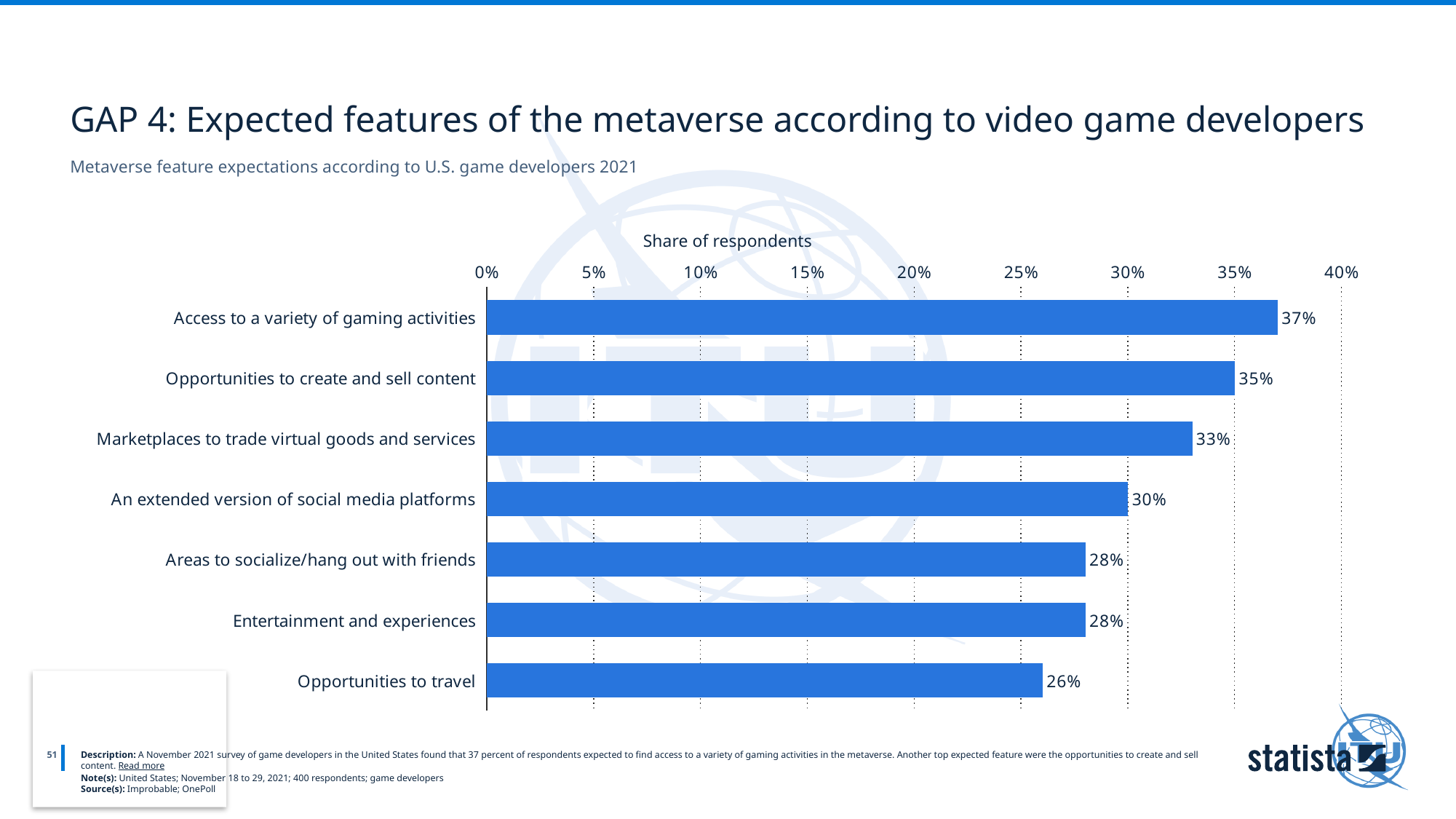
What is the difference between 'An extended version of social media platforms' and 'Areas to socialize/hang out with friends'? 2 percentage points What is the value for 'Marketplaces to trade virtual goods and services'? 33% What kind of chart is shown on the slide? Bar chart Which feature has the highest share of respondents? Access to a variety of gaming activities What is the label of the value axis of the chart? Share of respondents How many features are shown in the chart? 7 What share of respondents expected opportunities to travel? 26% What is the difference in percentage points between 'Access to a variety of gaming activities' and 'Opportunities to travel'? 11 percentage points Which is larger: the value for 'Opportunities to create and sell content' or for 'An extended version of social media platforms'? Opportunities to create and sell content What share of respondents expected access to a variety of gaming activities in the metaverse? 37% What share of respondents expected opportunities to create and sell content? 35% Which feature has the lowest share of respondents? Opportunities to travel